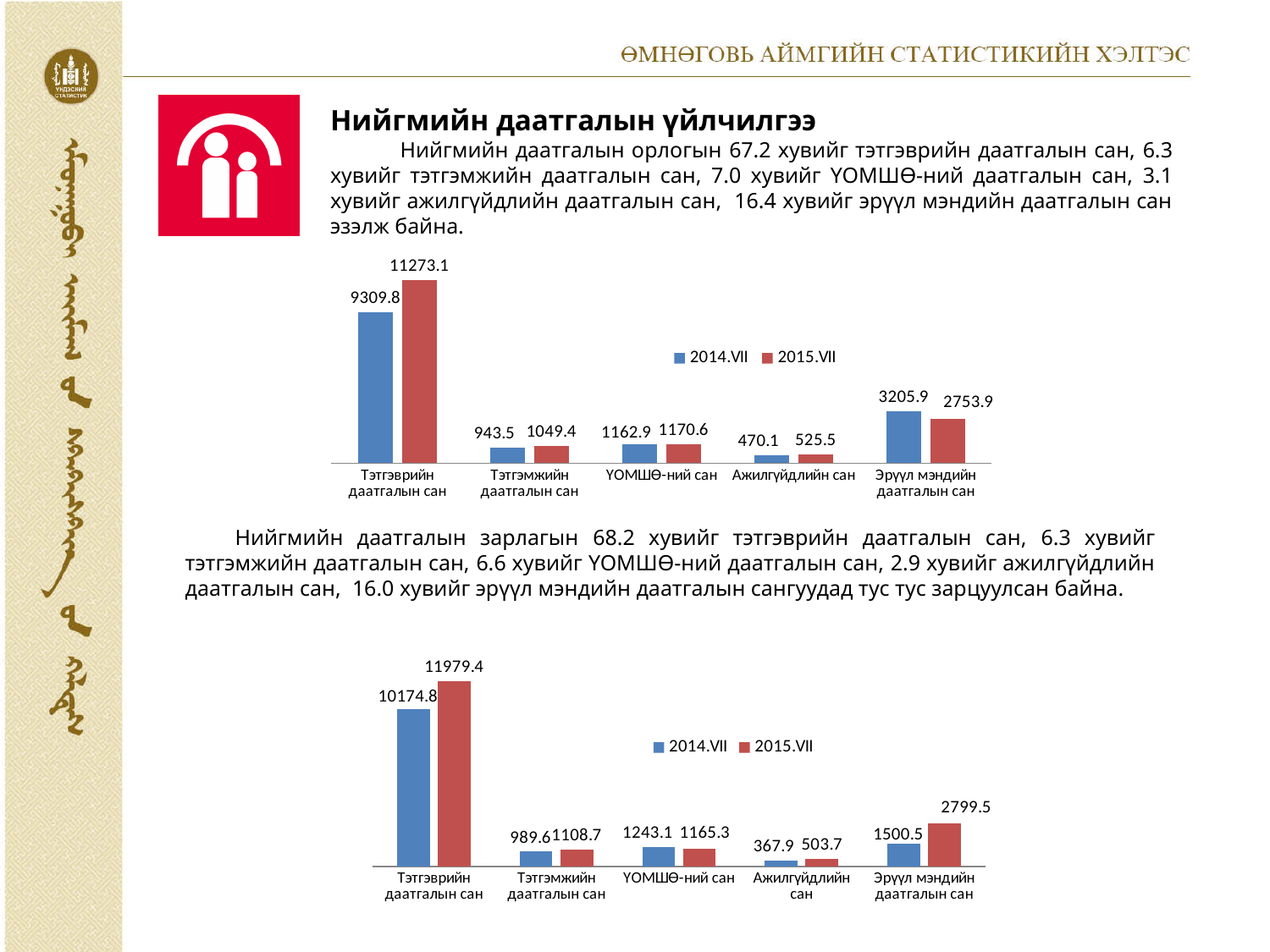
In the top chart, for Эрүүл мэндийн даатгалын сан, which is larger: the 2014.VII value or the 2015.VII value? 2014.VII In the top chart, which category has the lowest value for 2014.VII? Ажилгүйдлийн сан In the bottom chart, which colour represents the 2014.VII series? Blue How many categories are shown on the x axis of the bottom chart? 5 In the top chart, what is the value for Эрүүл мэндийн даатгалын сан in 2014.VII? 3205.9 In the bottom chart, what is the value for Ажилгүйдлийн сан in 2015.VII? 503.7 In the bottom chart, which category has the highest value for 2015.VII? Тэтгэврийн даатгалын сан In the top chart, what is the difference between the 2015.VII and 2014.VII values for Тэтгэврийн даатгалын сан? 1963.3 What type of chart is the bottom chart? Bar chart How many series does the legend of the top chart list? 2 In the top chart, what is the value for Тэтгэврийн даатгалын сан in 2015.VII? 11273.1 In the bottom chart, what is the difference between the 2015.VII and 2014.VII values for Эрүүл мэндийн даатгалын сан? 1299.0